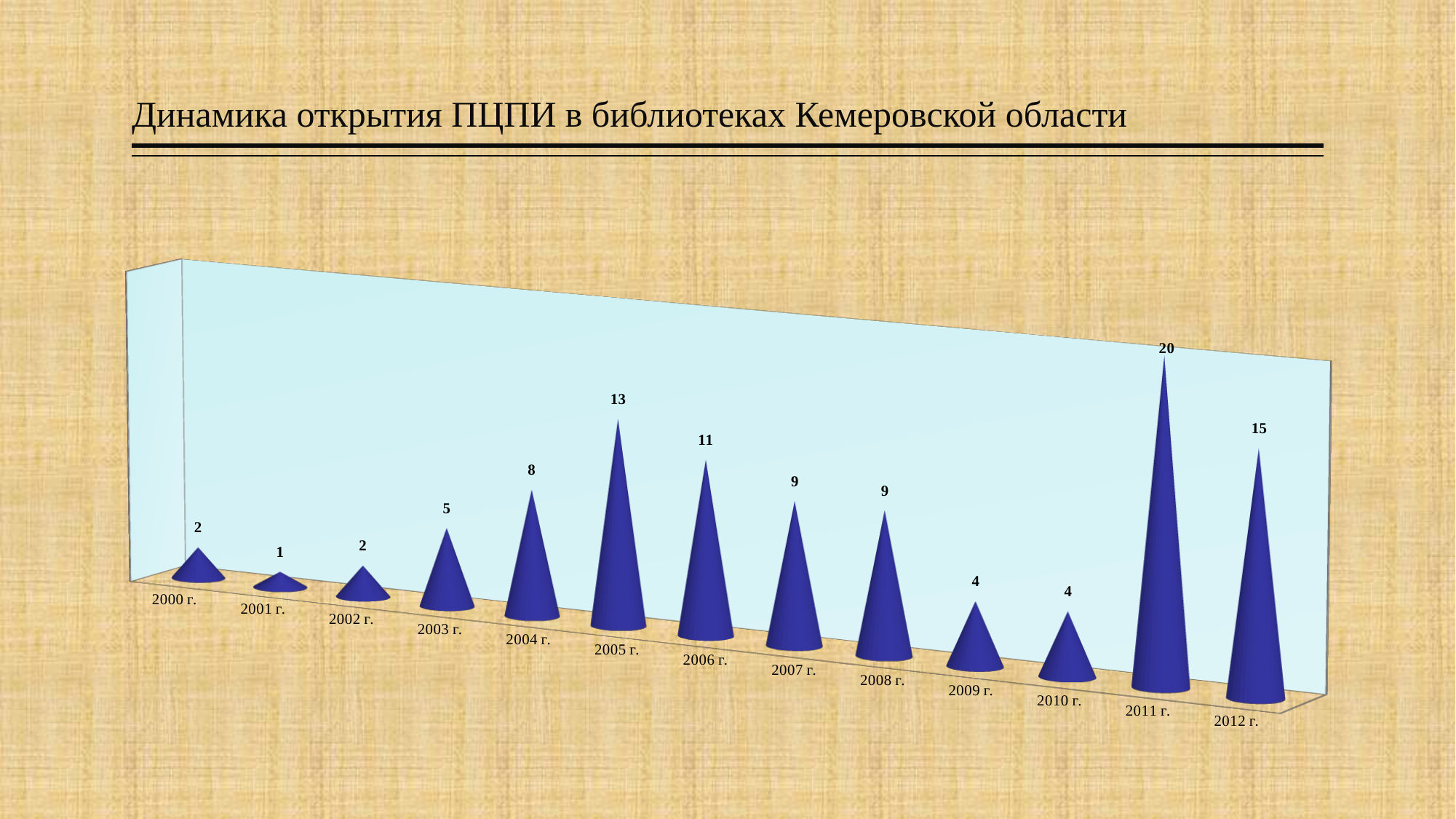
What is the value for 2009 г.? 4 What is the title of the chart on the slide? Динамика открытия ПЦПИ в библиотеках Кемеровской области What kind of chart is shown on the slide? bar chart What is the difference between the values for 2005 г. and 2004 г.? 5 What is the value for 2005 г.? 13 How many years are shown on the chart? 13 Which year has the highest value? 2011 г. What is the value for 2011 г.? 20 What is the difference between the values for 2011 г. and 2012 г.? 5 What is the value for 2001 г.? 1 Which year has the lowest value? 2001 г. Which is larger, the value for 2006 г. or the value for 2008 г.? 2006 г.